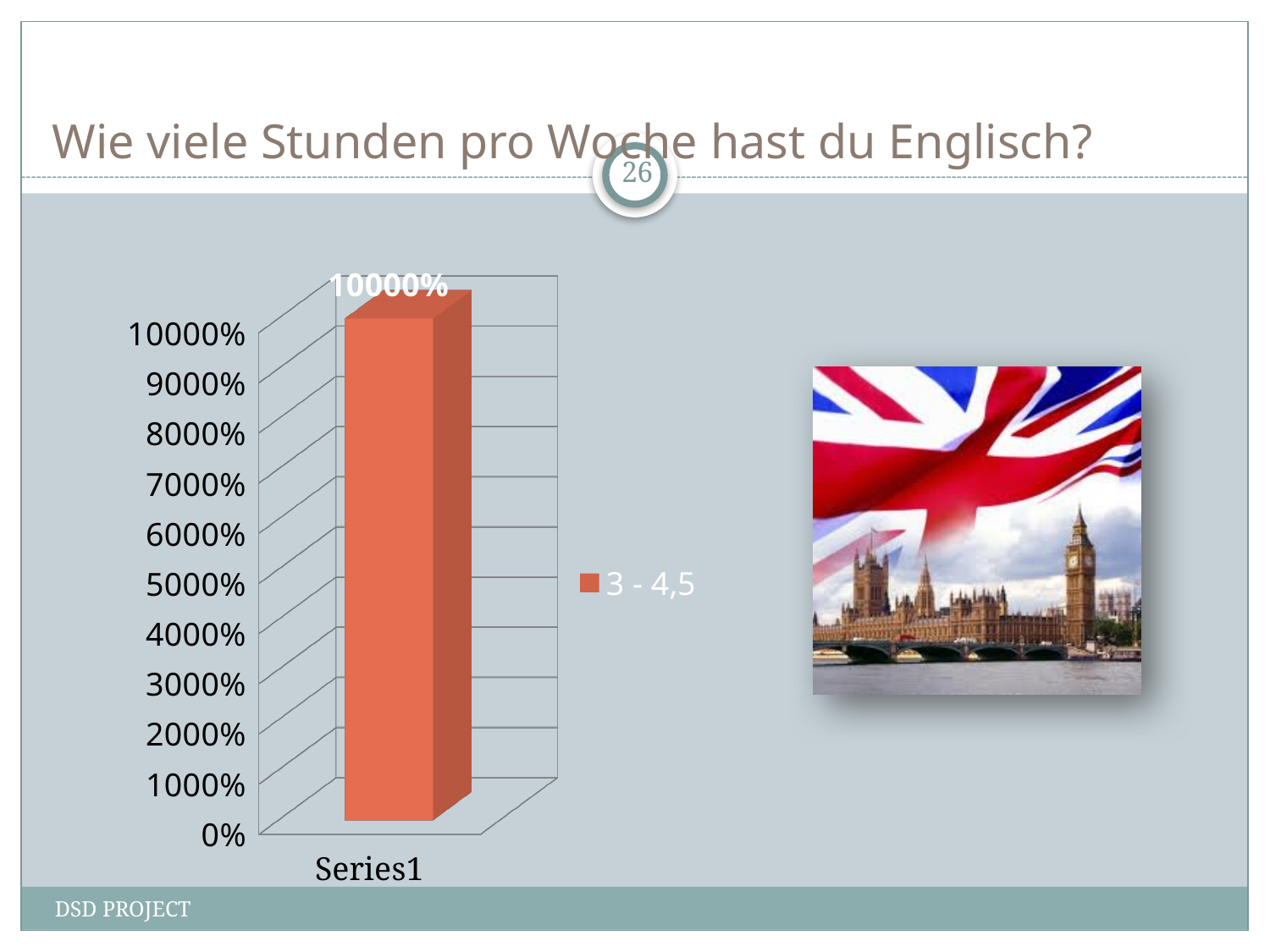
Is the value of the bar greater or less than 5000%? greater What value is printed on the bar in the chart? 10000% What kind of chart is shown on the slide? bar chart How many bars does the chart show? 1 How many entries does the chart's legend list? 1 What is the lowest value shown on the chart's vertical axis? 0% What is the highest value shown on the chart's vertical axis? 10000% What is the category label shown on the x axis of the chart? Series1 What is the legend entry of the chart? 3 - 4,5